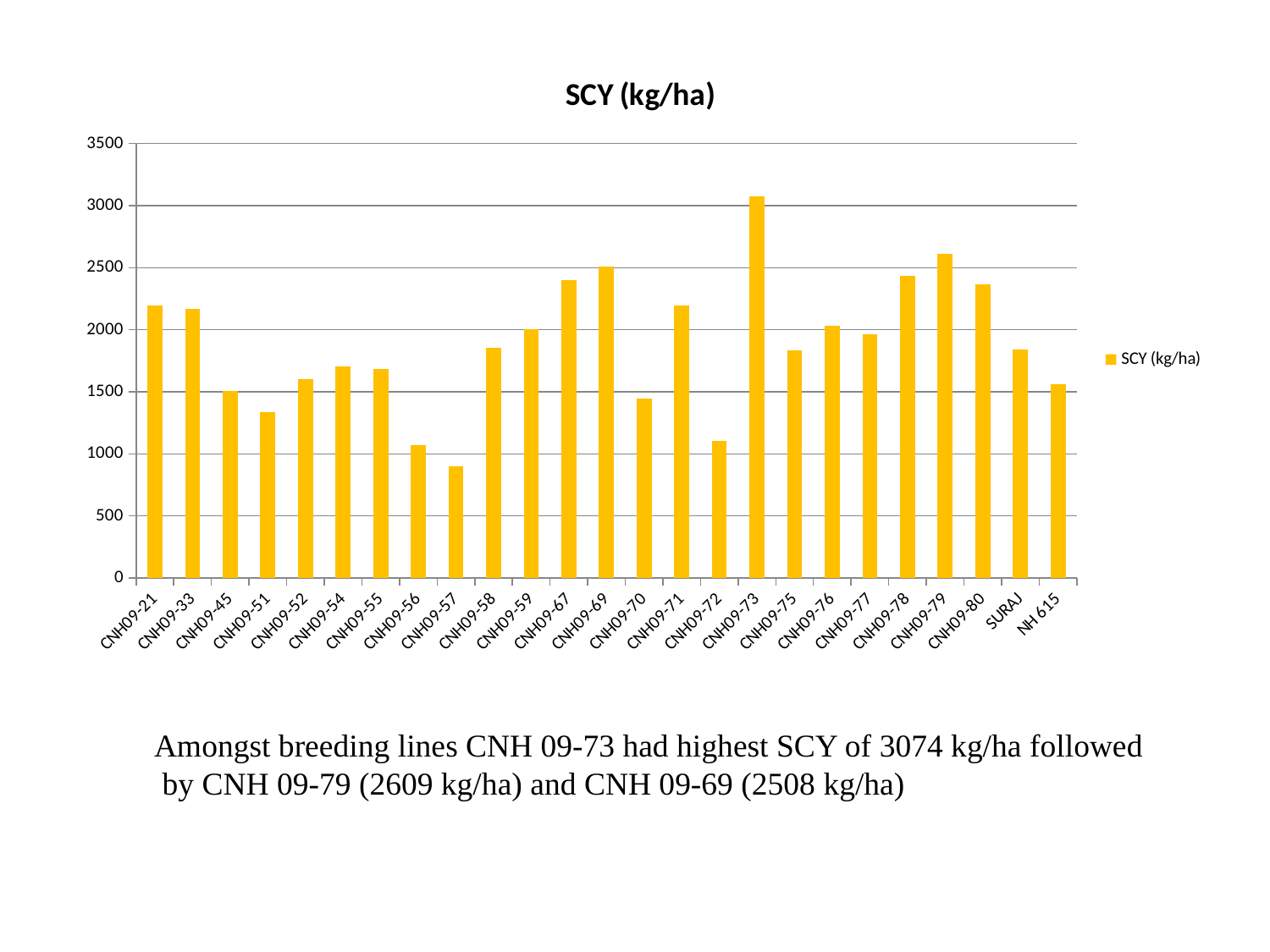
What is the title of the chart? SCY (kg/ha) What is the SCY of CNH 09-79 in kg/ha? 2609 kg/ha Which has a higher SCY, CNH09-21 or CNH09-45? CNH09-21 What type of chart is shown on the slide? bar chart Is the SCY value for CNH09-57 greater or less than 1000? less Which breeding line has the highest SCY? CNH09-73 How many series does the legend list? 1 Is the SCY value for SURAJ greater or less than 2000? less What is the SCY of CNH 09-73 in kg/ha? 3074 kg/ha What is the difference in SCY between CNH 09-73 and CNH 09-79? 465 kg/ha How many breeding lines (categories) are plotted on the x axis? 25 Which breeding line has the lowest SCY? CNH09-57